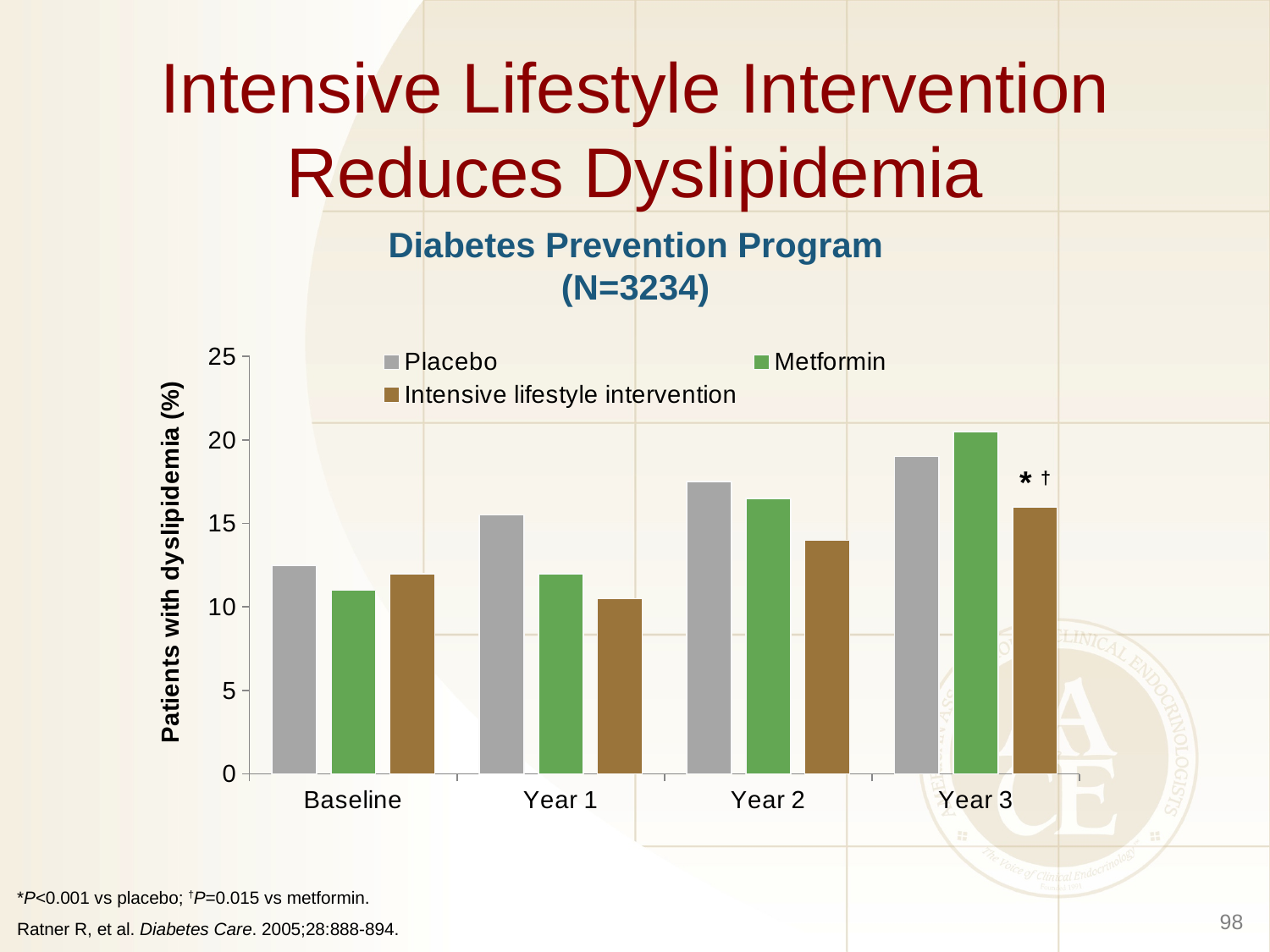
How many time-point categories are shown on the x axis? 4 Is the Placebo value at Year 2 greater or less than 15? greater What kind of chart is shown on the slide? Bar chart Do the Placebo values rise or fall from Baseline to Year 3? Rise Which series has the highest bar at Year 3? Metformin Which series has the lowest bar at Year 1? Intensive lifestyle intervention How many series does the legend list? 3 Is the Placebo value at Baseline greater or less than 15? less Is the Metformin value at Year 3 greater or less than 20? greater What is the label on the y axis? Patients with dyslipidemia (%) At Year 2, which is larger: the Placebo value or the Intensive lifestyle intervention value? Placebo